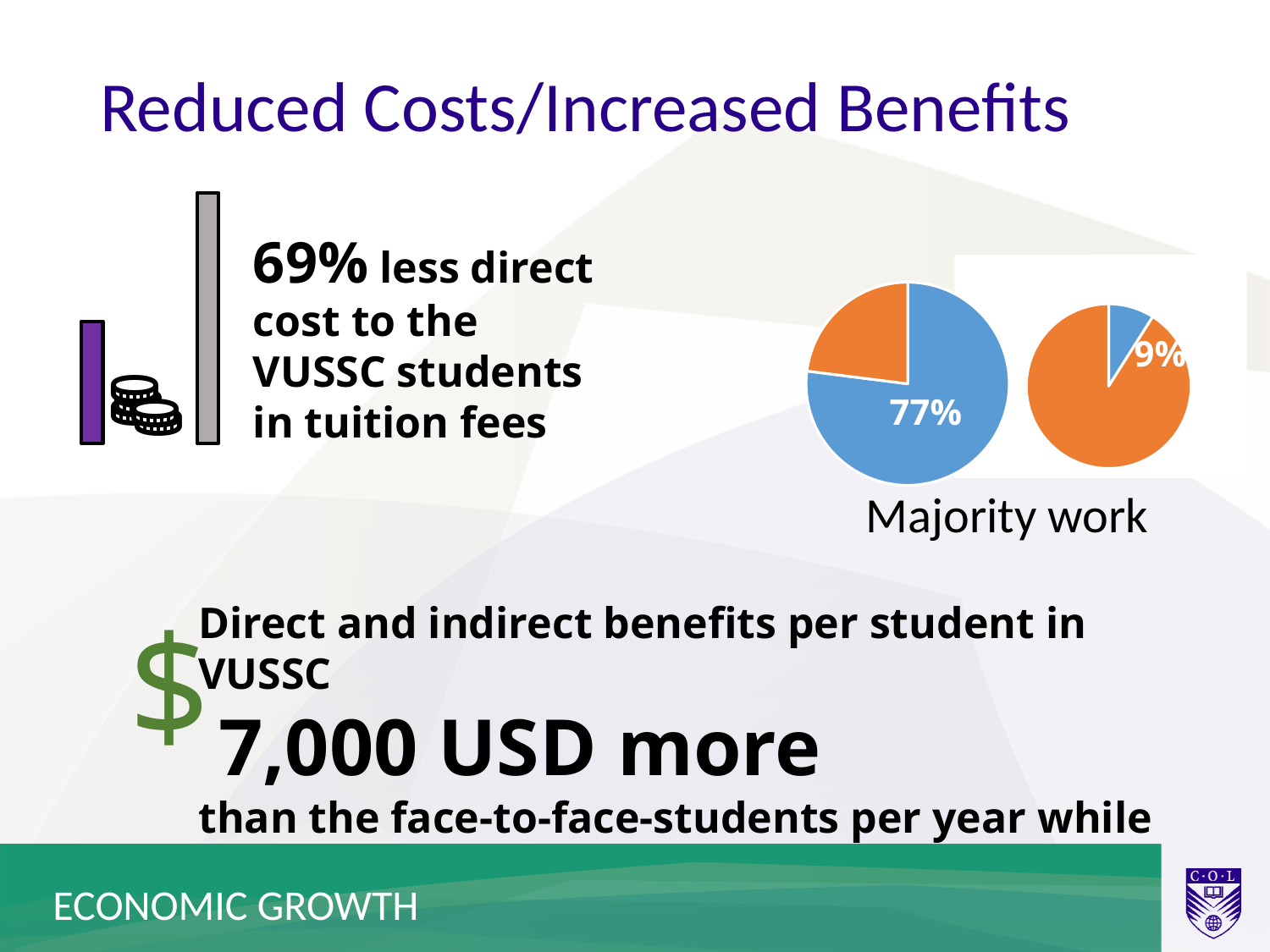
Which pie chart has the larger blue slice, the left one or the right one? The left one In the left pie chart, which slice is larger, the blue one or the orange one? Blue Is the blue slice in the left pie chart greater or less than 50% of the pie? greater In the left pie chart, what percentage is printed on the blue slice? 77% How many slices does the left pie chart have? 2 In the right pie chart, what percentage is printed on the blue slice? 9% What two colours are used for the slices in the pie charts? Blue and orange How many slices does the right pie chart have? 2 In the right pie chart, which slice is larger, the blue one or the orange one? Orange What is the difference between the blue-slice percentage in the left pie chart and the blue-slice percentage in the right pie chart? 68 percentage points What kind of charts are shown under the heading "Majority work"? Pie charts What caption appears below the two pie charts? Majority work